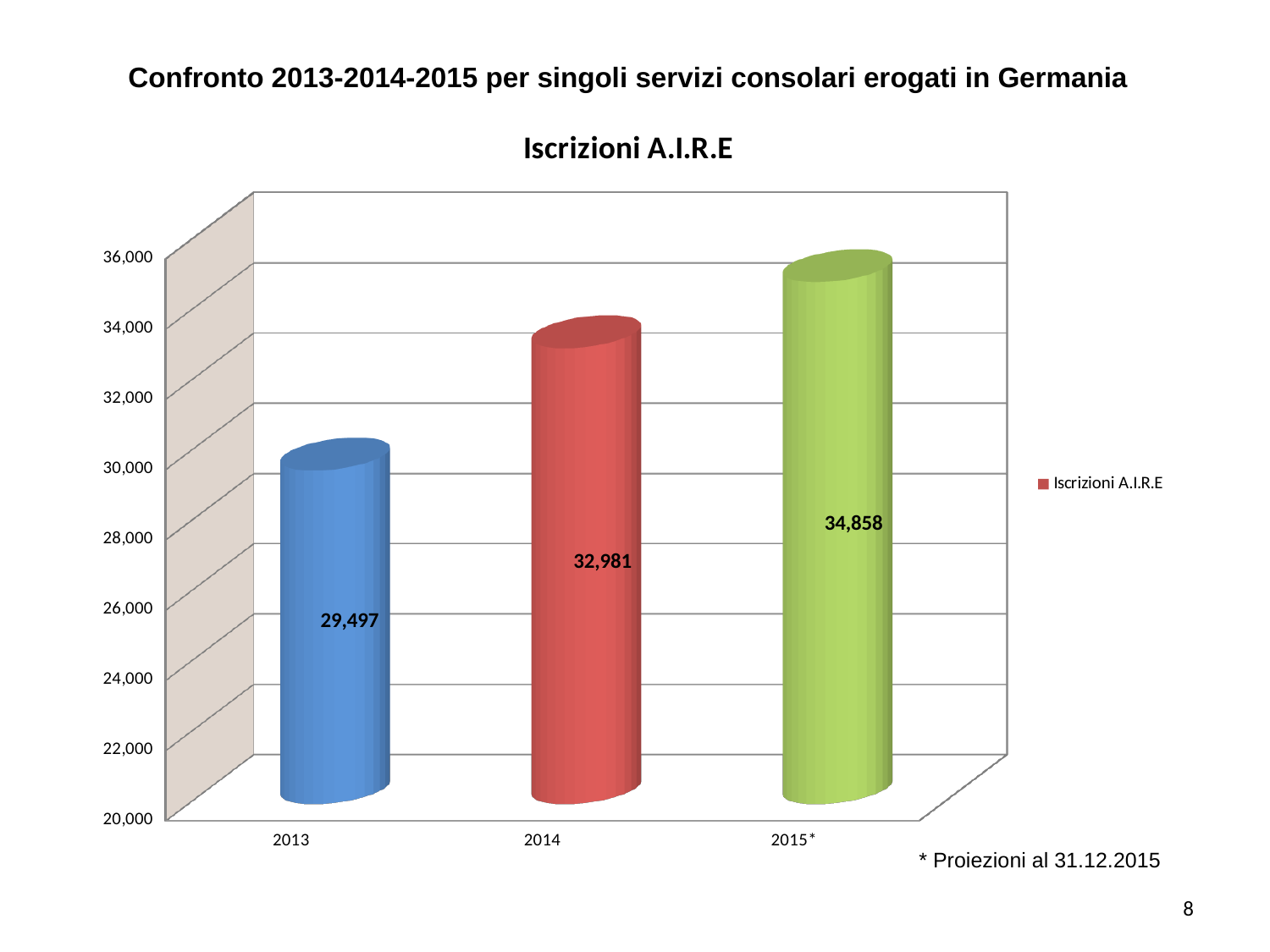
Which is larger in the Iscrizioni A.I.R.E chart, the value for 2013 or the value for 2014? 2014 What is the difference between the 2015* and 2014 values in the Iscrizioni A.I.R.E chart? 1,877 Which year has the lowest value in the Iscrizioni A.I.R.E chart? 2013 Is the value for 2015* greater or less than 34,000? greater What is the value for 2013 in the Iscrizioni A.I.R.E chart? 29,497 Do the values rise or fall from 2013 to 2015* in the Iscrizioni A.I.R.E chart? rise Which year has the highest value in the Iscrizioni A.I.R.E chart? 2015* What kind of chart is shown on the slide? bar chart How many years are shown on the x axis of the Iscrizioni A.I.R.E chart? 3 What is the difference between the 2014 and 2013 values in the Iscrizioni A.I.R.E chart? 3,484 What is the value for 2014 in the Iscrizioni A.I.R.E chart? 32,981 What is the value for 2015* in the Iscrizioni A.I.R.E chart? 34,858